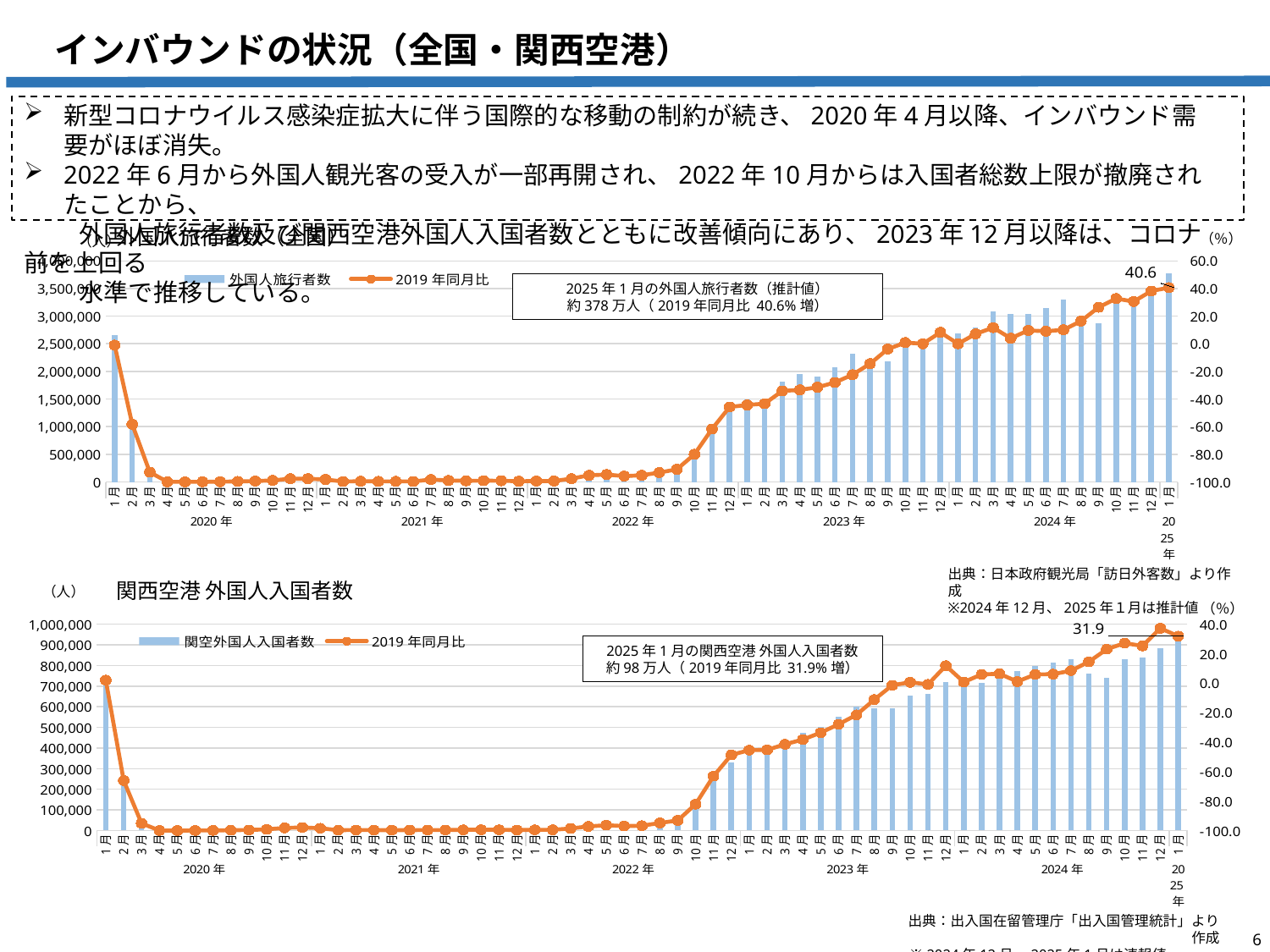
On the 関西空港 外国人入国者数 chart, is the bar value for 2020年1月 greater or less than 500,000? greater According to the annotation box on the top chart, what is the estimated number of foreign travellers in 2025年1月? 約378万人 On the 関西空港 外国人入国者数 chart, what are the two legend entries? 関空外国人入国者数, 2019年同月比 On the 関西空港 外国人入国者数 chart, what data label is shown for the 2019年同月比 line at the final point (2025年1月)? 31.9 On the top chart, which bar is larger: 2020年1月 or 2021年1月? 2020年1月 On the 関西空港 外国人入国者数 chart, is the bar value for 2024年12月 greater or less than 800,000? greater On the top chart, does the 2019年同月比 line rise or fall from 2020年1月 to 2020年4月? fall On the top chart, is the bar value for 2020年1月 greater or less than 2,000,000? greater What kind of chart is the 関西空港 外国人入国者数 chart? Combined bar and line chart On the top chart, what data label is shown for the 2019年同月比 line at the final point (2025年1月)? 40.6 On the top chart, how many series does the legend list? 2